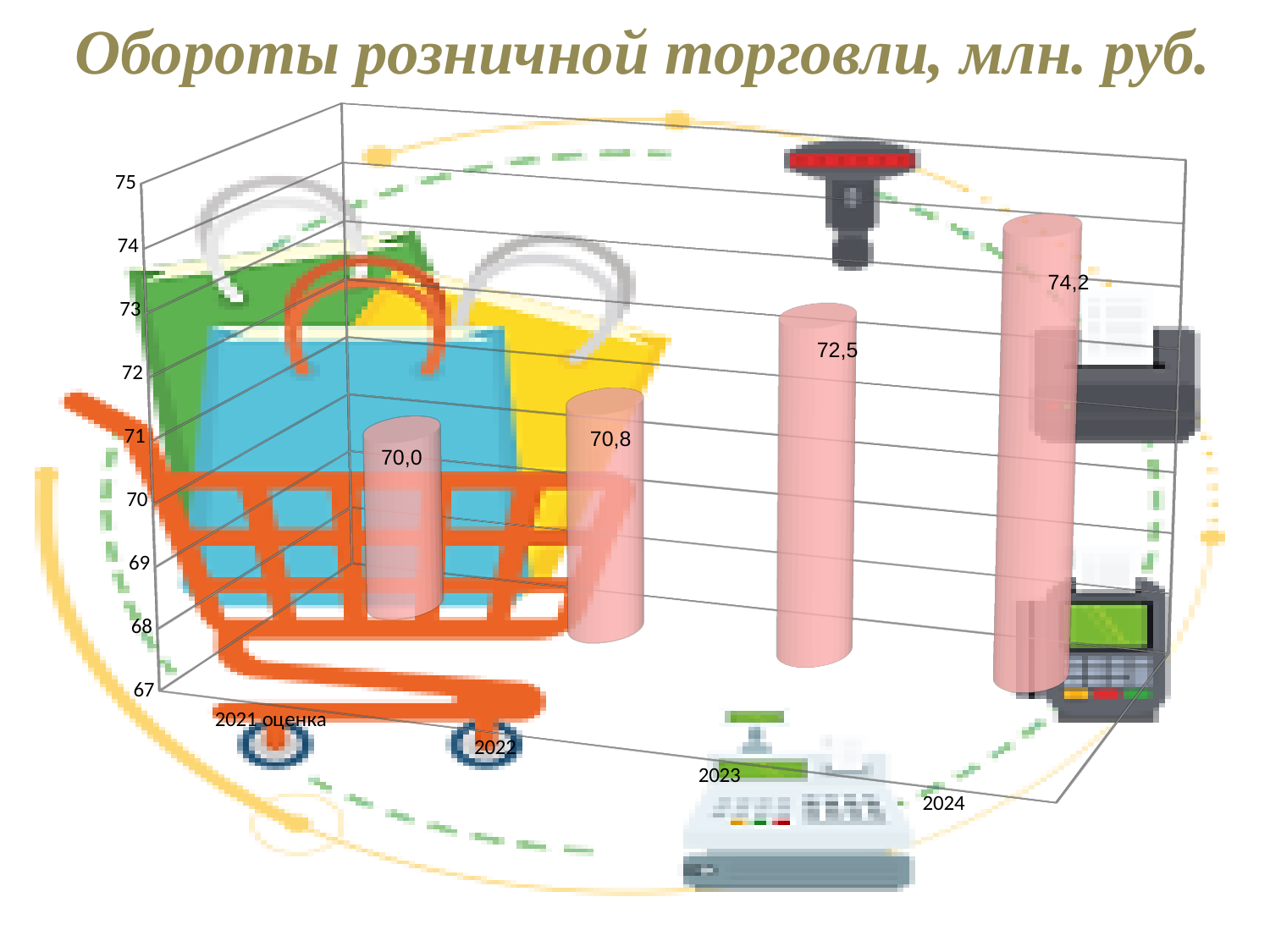
What is the difference between the values for 2024 and 2023? 1,7 What is the value for 2023? 72,5 What is the value for 2024? 74,2 Which category has the lowest value? 2021 оценка Which category has the highest value? 2024 Do the values rise or fall from 2021 оценка to 2024? rise What is the title of the chart? Обороты розничной торговли, млн. руб. What kind of chart is shown on the slide? bar chart What is the value for 2021 оценка? 70,0 How many categories are shown on the chart? 4 Which is larger, the value for 2022 or the value for 2023? 2023 What is the value for 2022? 70,8